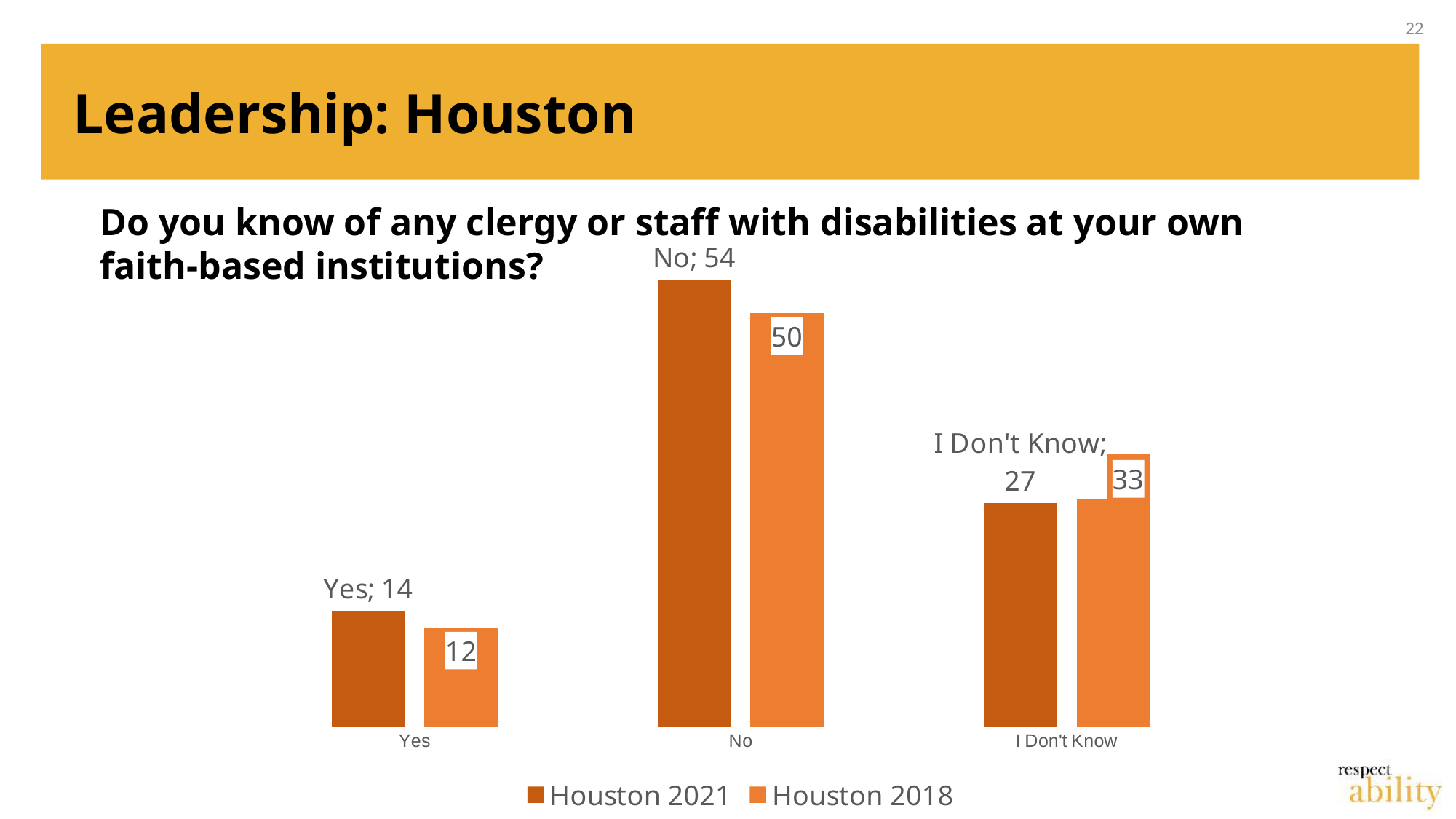
How many series does the legend list? 2 What is the value for "No" in the Houston 2021 series? 54 What is the difference between the Houston 2018 and Houston 2021 values for "I Don't Know"? 6 What is the value for "I Don't Know" in the Houston 2018 series? 33 Which category has the highest value in the Houston 2021 series? No What kind of chart is shown on the slide? Bar chart What is the value for "I Don't Know" in the Houston 2021 series? 27 What is the difference between the Houston 2021 and Houston 2018 values for "No"? 4 Which category has the lowest value in the Houston 2018 series? Yes What is the value for "Yes" in the Houston 2018 series? 12 How many categories are shown on the x axis? 3 Which series has the larger value for "Yes", Houston 2021 or Houston 2018? Houston 2021